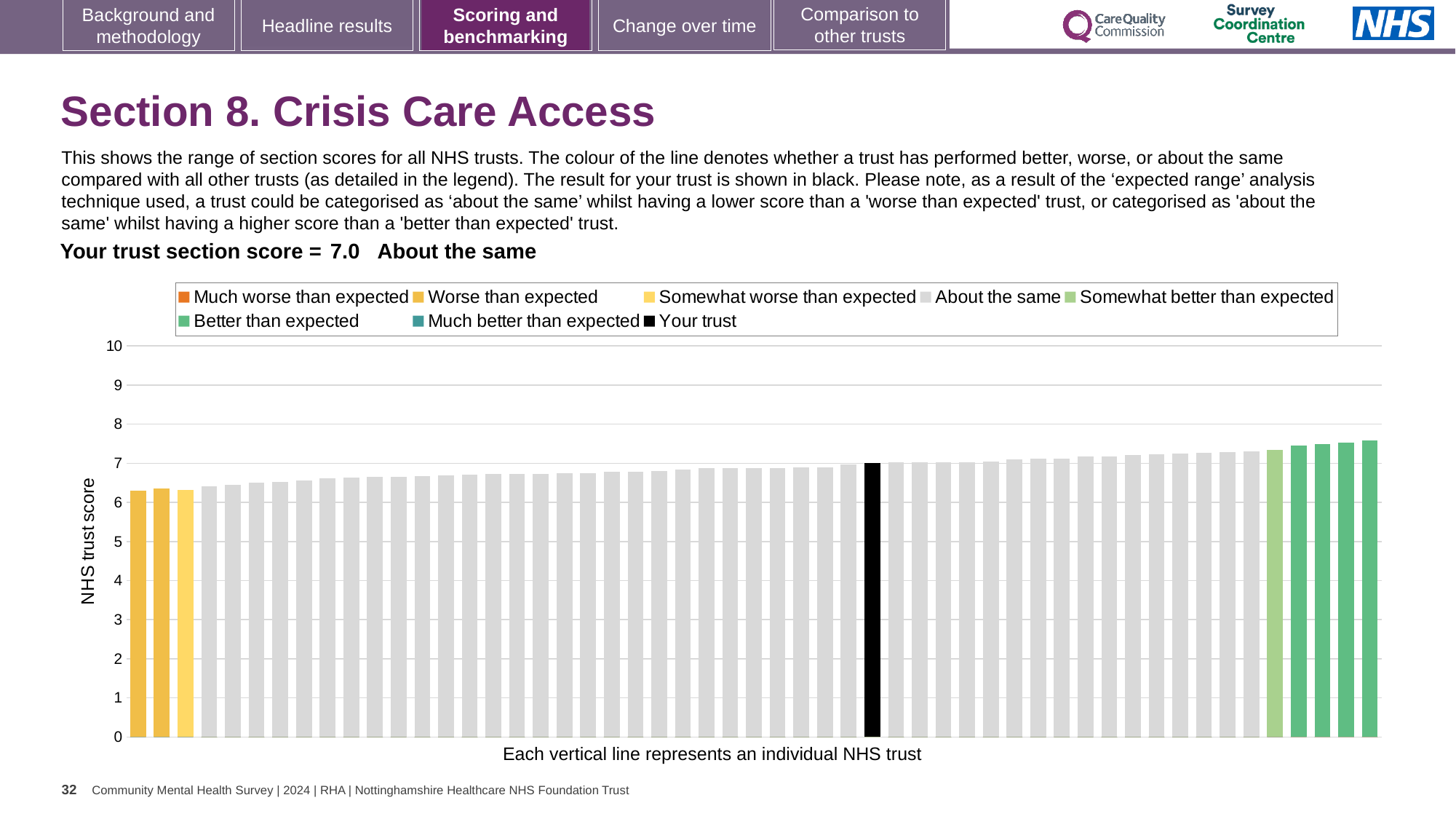
What colour is the bar representing your trust? black How many bars are coloured as 'Worse than expected'? 2 What is the section score for your trust? 7.0 What is the label on the vertical axis of the chart? NHS trust score How many bars are coloured as 'Better than expected'? 4 Do the bar values rise or fall from left to right along the x axis? rise Is the value of the lowest bar greater or less than 6? greater What kind of chart is shown on the slide? bar chart Is the value for your trust greater or less than 5? greater How many entries does the chart legend list? 8 Is the value of the highest bar greater or less than 8? less Which category is your trust placed in for this section? About the same